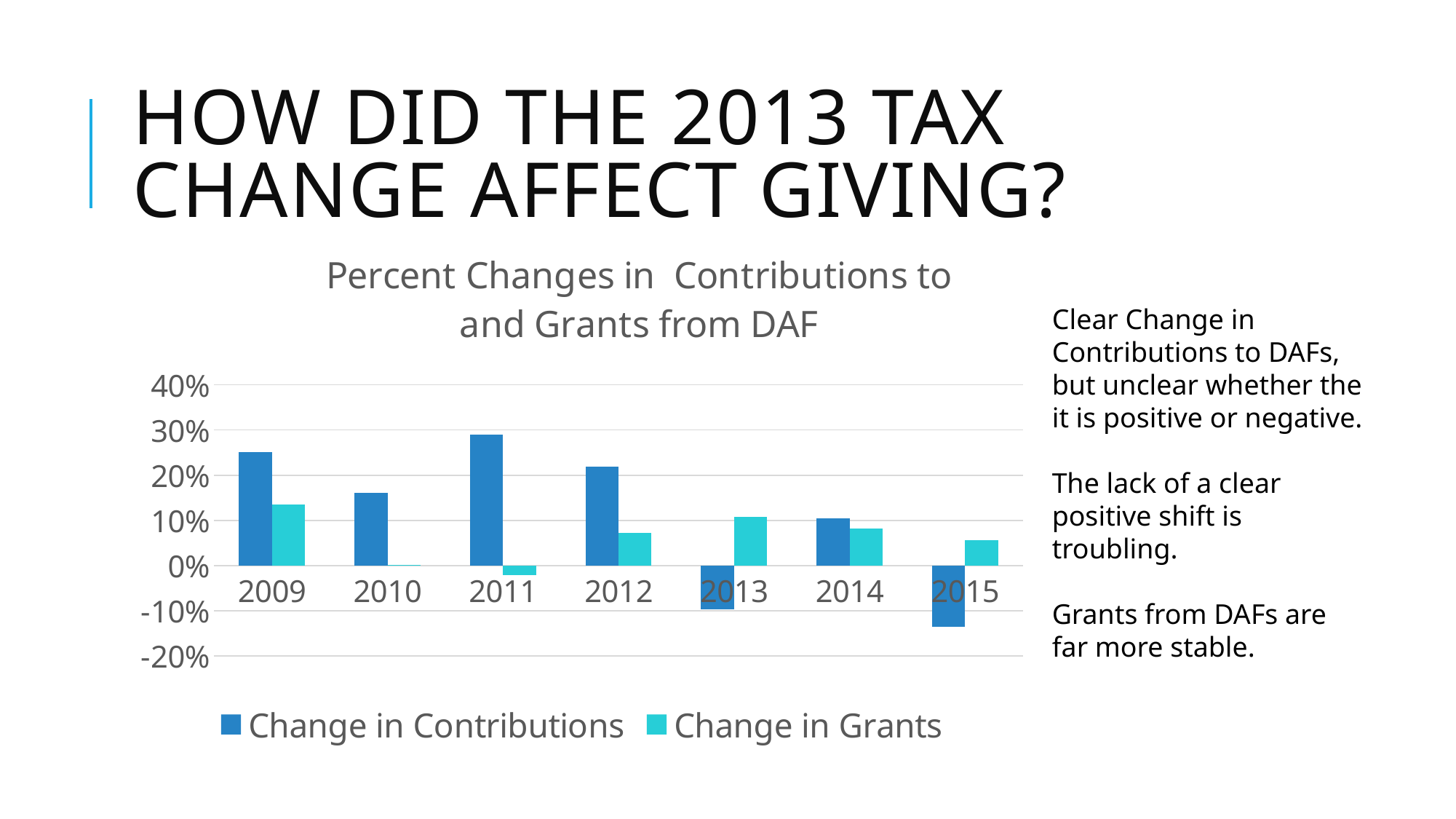
Is the Change in Grants for 2012 greater or less than 10%? less Is the Change in Contributions for 2013 greater or less than 0%? less How many series does the chart legend list? 2 In 2009, which is larger: Change in Contributions or Change in Grants? Change in Contributions In which year is the Change in Contributions lowest? 2015 In 2013, which is larger: Change in Contributions or Change in Grants? Change in Grants Is the Change in Contributions for 2011 greater or less than 20%? greater How many years are shown on the x axis of the chart? 7 In which year is the Change in Grants lowest? 2011 In which year is the Change in Contributions highest? 2011 What is the title of the chart? Percent Changes in Contributions to and Grants from DAF What kind of chart is shown on the slide? bar chart